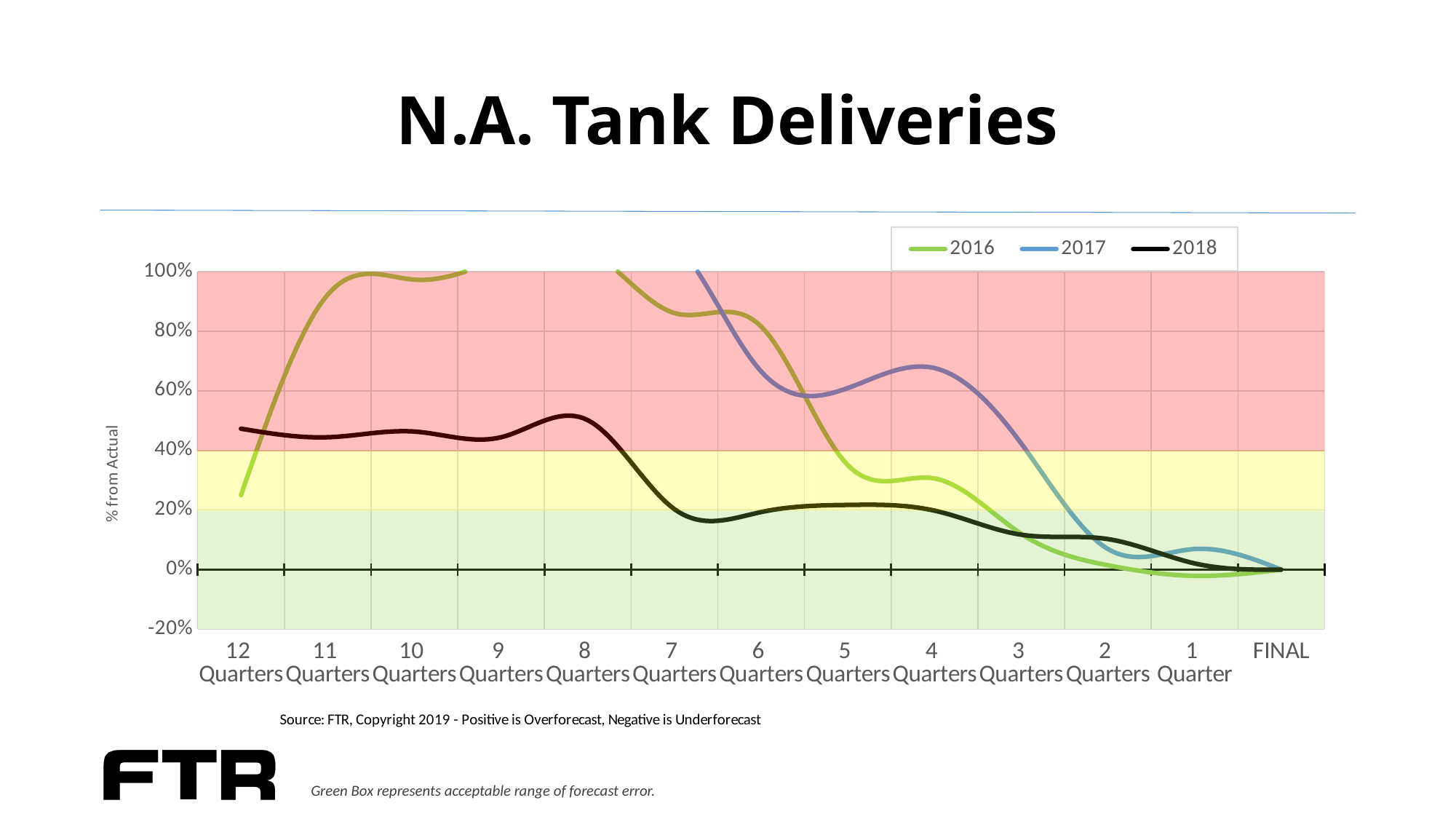
At 5 Quarters, which series has the larger value, 2016 or 2017? 2017 How many series does the legend list? 3 Does the 2018 line rise or fall from 8 Quarters to FINAL? fall What is the label on the y axis? % from Actual Is the value for 2017 at 4 Quarters greater or less than 60%? greater Is the value for 2016 at 4 Quarters greater or less than 40%? less Is the value for 2018 at 12 Quarters greater or less than 40%? greater At 10 Quarters, which series has the larger value, 2016 or 2018? 2016 How many categories are shown along the x axis? 13 What kind of chart is shown on the slide? line chart